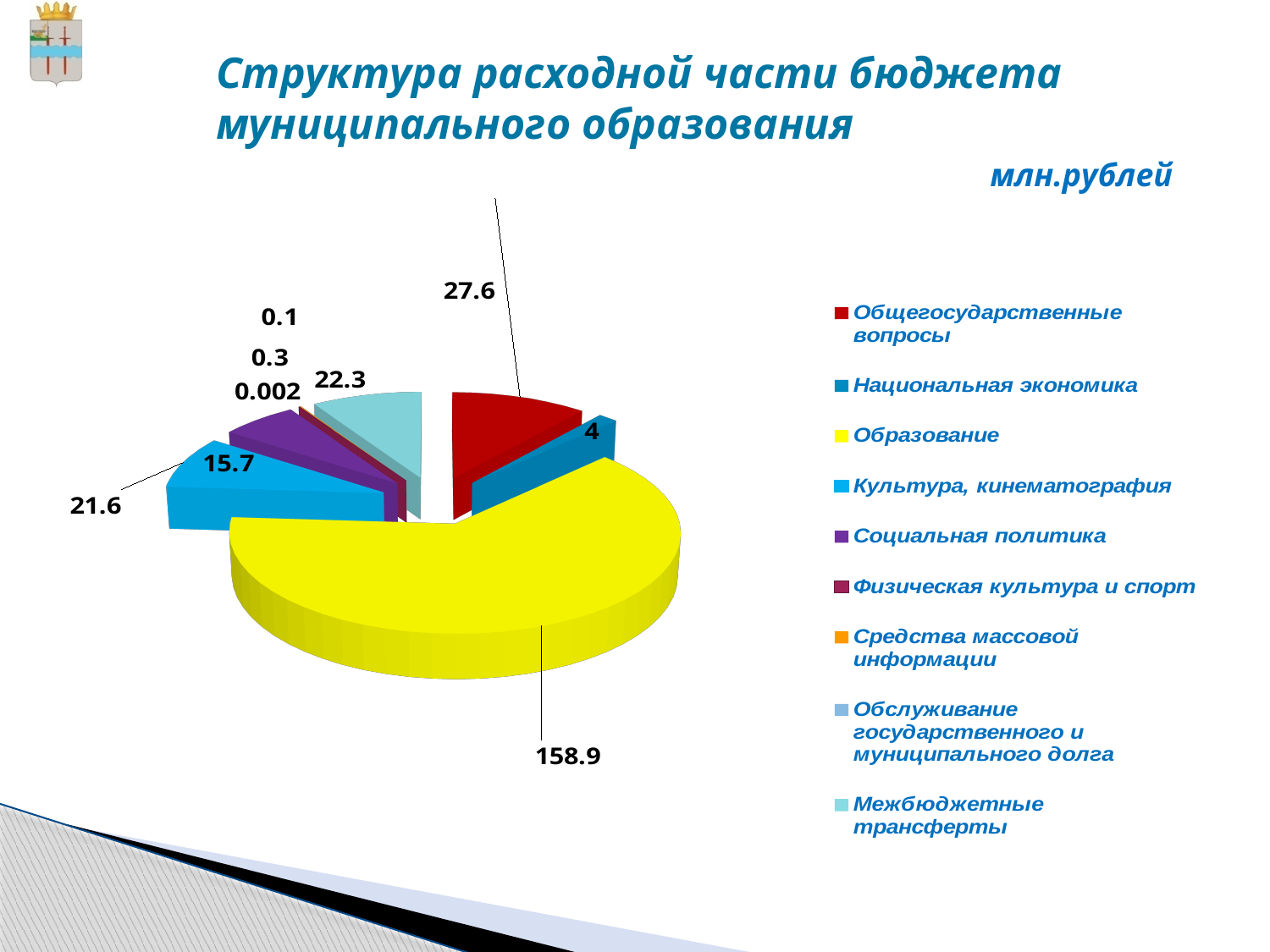
In what units are the values of the pie chart given, according to the slide? млн.рублей How many categories does the legend of the pie chart list? 9 Which is larger in the pie chart: Общегосударственные вопросы or Национальная экономика? Общегосударственные вопросы What is the value for Общегосударственные вопросы in the pie chart? 27.6 What is the value for Культура, кинематография in the pie chart? 21.6 What is the value for Национальная экономика in the pie chart? 4 What is the difference between the values for Образование and Общегосударственные вопросы? 131.3 What kind of chart is shown on the slide? pie chart What is the value for Образование in the pie chart? 158.9 What is the smallest value printed on the pie chart? 0.002 What is the value for Межбюджетные трансферты in the pie chart? 22.3 Which category has the largest slice in the pie chart? Образование